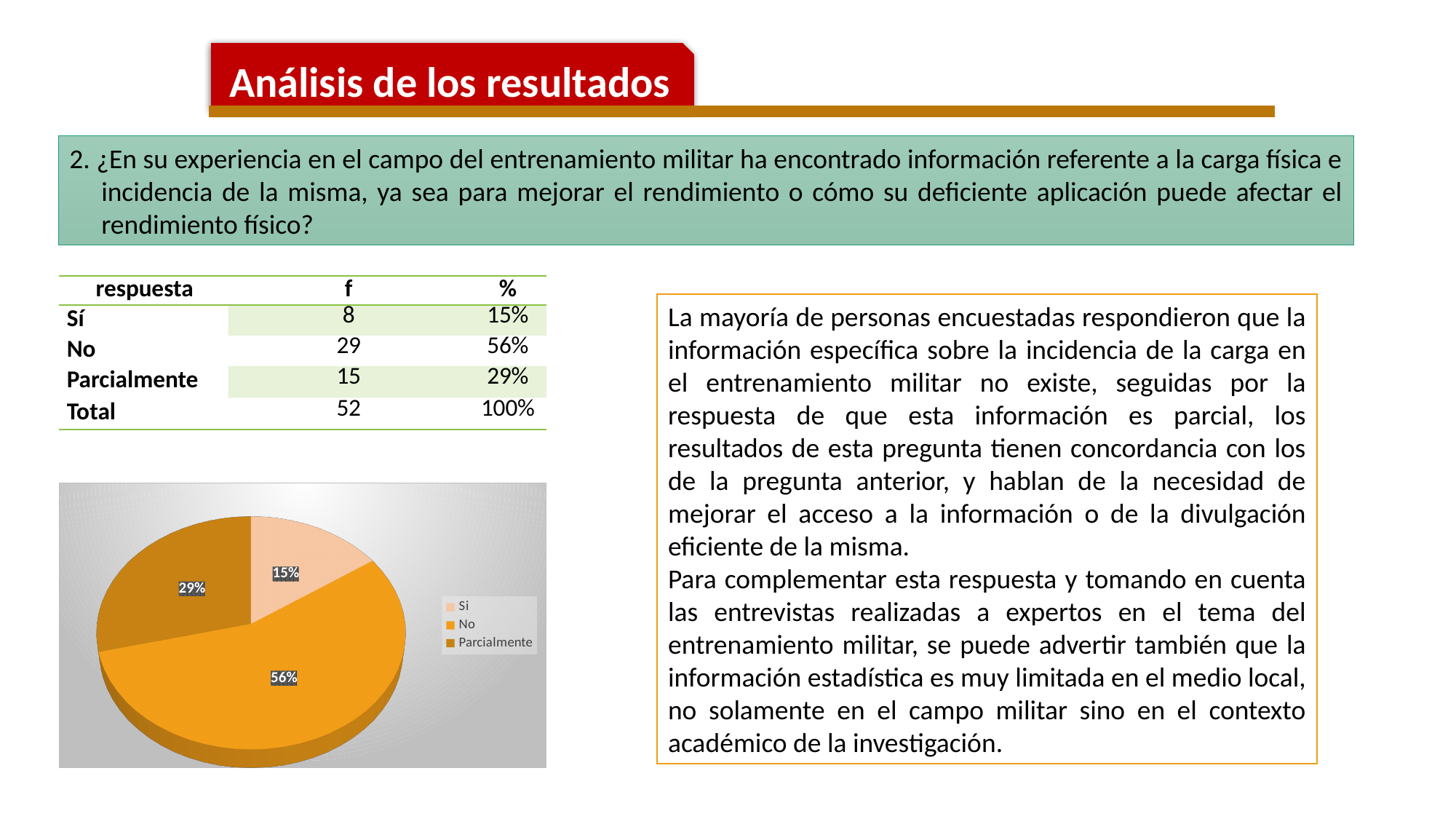
What share of the pie does the 'No' slice represent? 56% Which legend entry is shown in the lightest colour in the pie chart? Si What share of the pie does the 'Parcialmente' slice represent? 29% What is the difference in percentage points between the 'Parcialmente' slice and the 'Si' slice? 14% How many entries does the legend of the pie chart list? 3 Which slice of the pie chart is the largest? No What share of the pie does the 'Si' slice represent? 15% How many slices does the pie chart have? 3 Which slice of the pie chart is the smallest? Si What is the difference in percentage points between the 'No' slice and the 'Parcialmente' slice? 27% Which slice is larger, 'Parcialmente' or 'Si'? Parcialmente What kind of chart is shown on the slide? pie chart